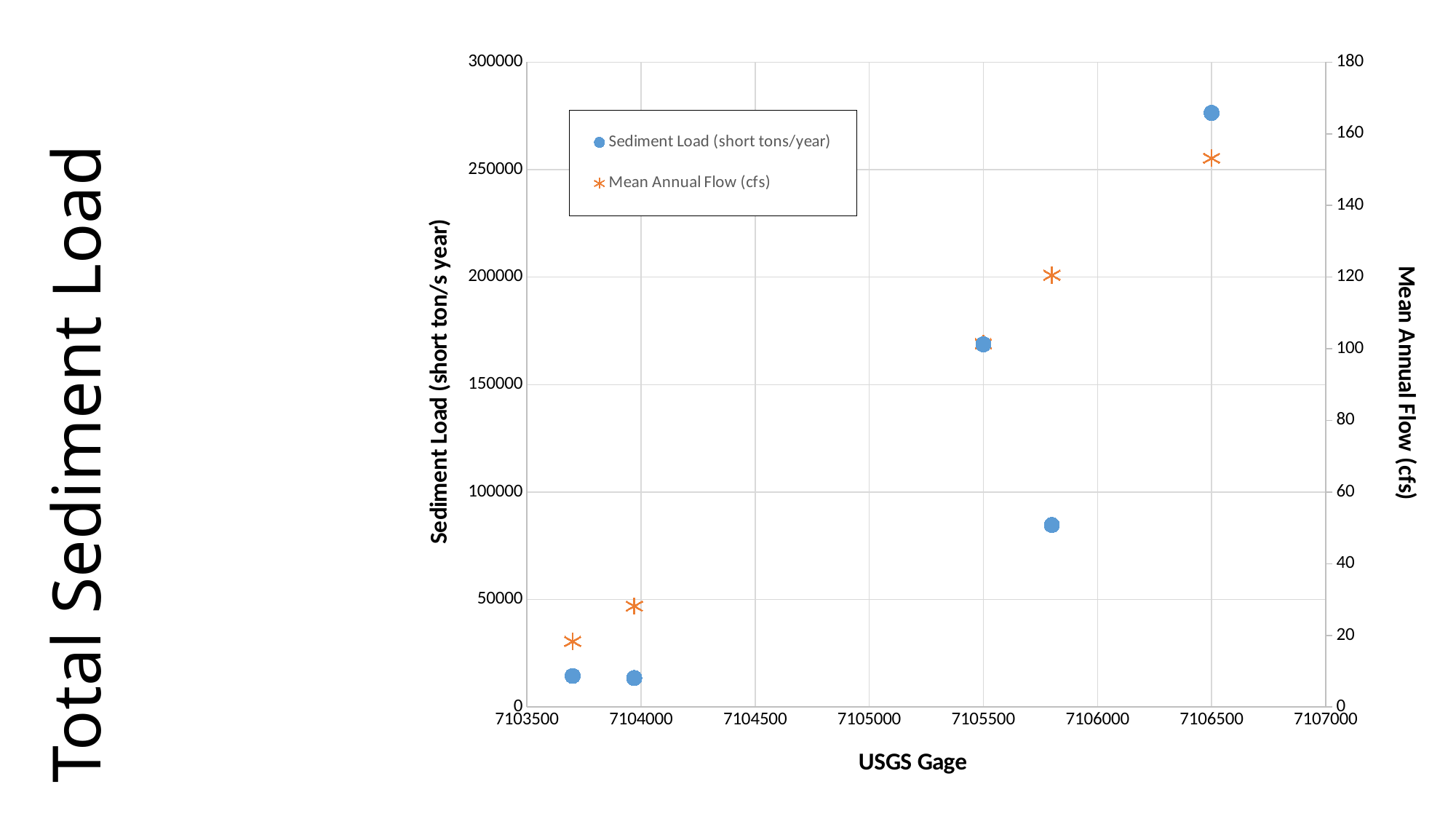
Which has the larger Sediment Load: the point near gage 7105500 or the point near gage 7105800? the point near gage 7105500 Does Mean Annual Flow rise or fall as the USGS Gage number increases along the x axis? rise Which point has the highest Sediment Load? the rightmost point, near gage 7106500 What kind of chart is shown on the slide? scatter chart Which series is plotted with orange asterisk markers? Mean Annual Flow (cfs) Is the Sediment Load for the rightmost point (near gage 7106500) greater or less than 250000? greater Is the Mean Annual Flow for the leftmost point (near gage 7103700) greater or less than 40? less What is the title of the x axis? USGS Gage How many Sediment Load points are plotted on the chart? 5 Is the Sediment Load for the point near gage 7105800 greater or less than 100000? less How many series does the legend list? 2